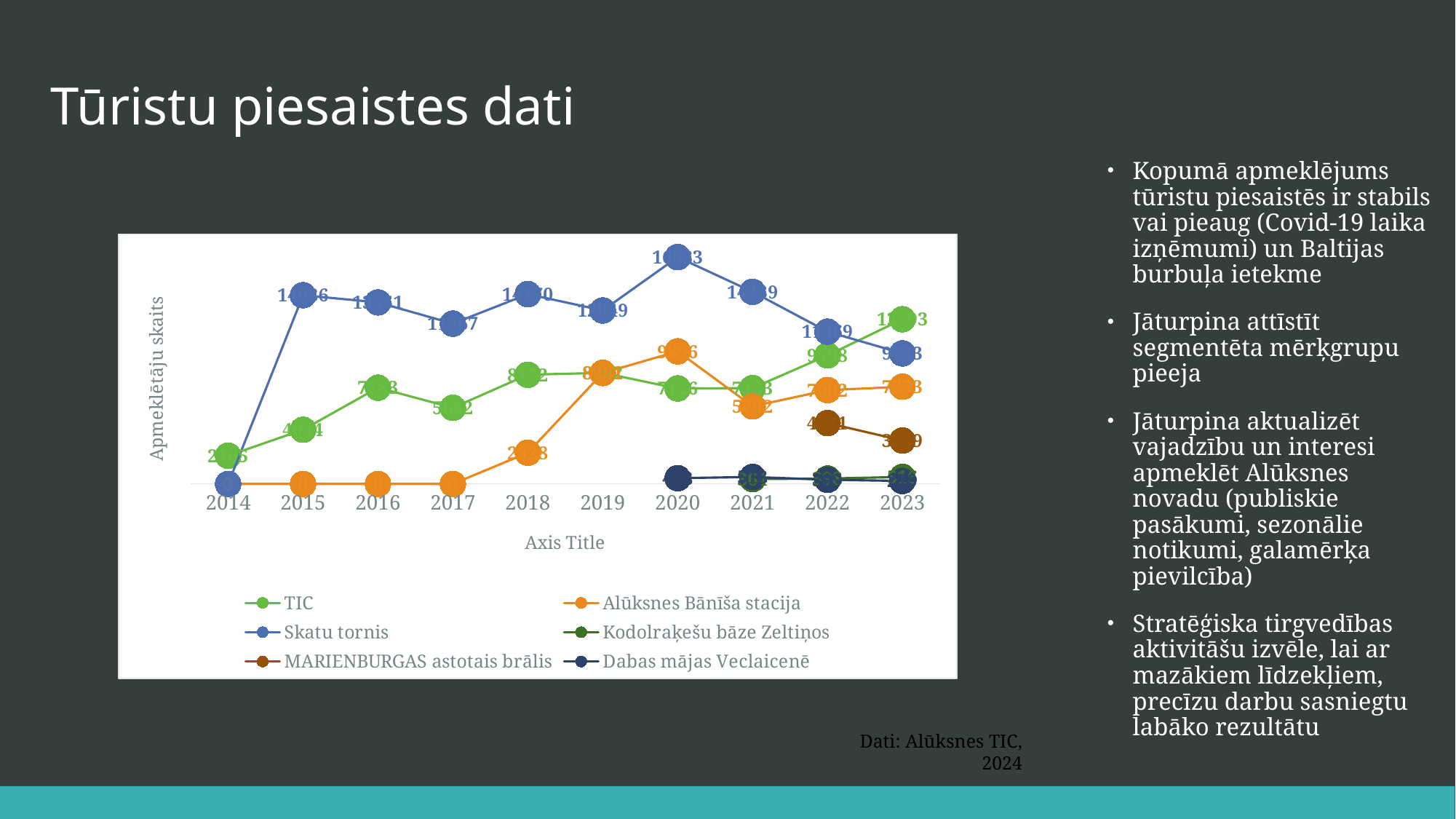
Does the Skatu tornis series rise or fall from 2020 to 2023? Fall What kind of chart is shown on the slide? Line chart Does the Alūksnes Bānīša stacija series rise or fall from 2017 to 2020? Rise In 2023, which is larger: the value for TIC or the value for Skatu tornis? TIC Which series has the highest value in 2020? Skatu tornis Does the MARIENBURGAS astotais brālis series rise or fall from 2022 to 2023? Fall In 2022, which is larger: the value for Skatu tornis or the value for TIC? Skatu tornis What is the title of the vertical axis of the chart? Apmeklētāju skaits How many years are shown along the x axis of the chart? 10 In which year does the Skatu tornis series reach its highest value? 2020 How many series does the chart legend list? 6 Which series has the highest value in 2023? TIC